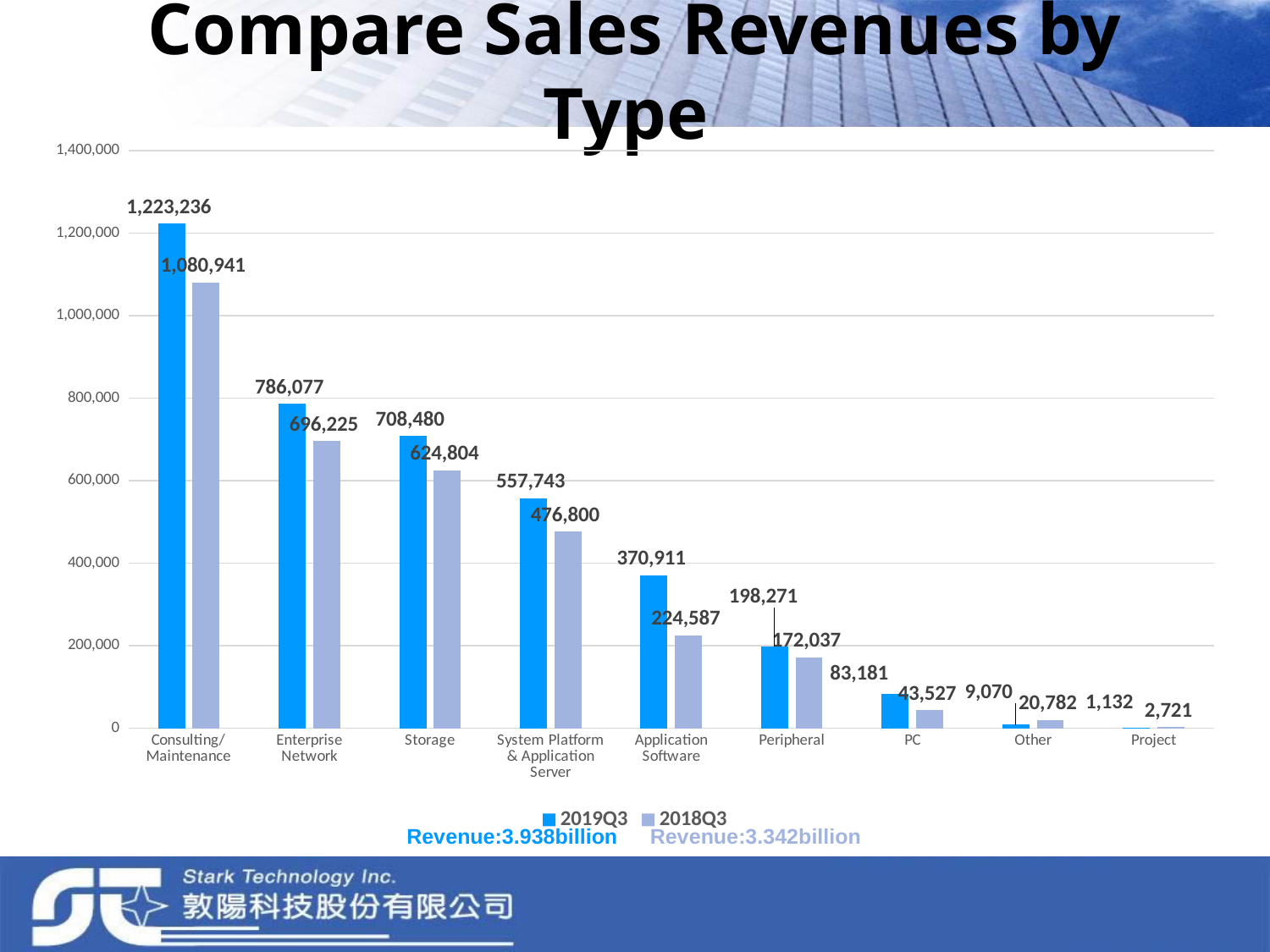
What is the difference between the 2019Q3 and 2018Q3 values for Consulting/Maintenance? 142,295 What is the 2018Q3 value for PC? 43,527 What is the 2019Q3 value for Application Software? 370,911 Which category has the highest 2019Q3 value? Consulting/Maintenance What kind of chart is shown on the slide? Bar chart How many series does the legend list? 2 Which category has the lowest 2019Q3 value? Project What is the 2018Q3 value for Storage? 624,804 What is the difference between the 2018Q3 and 2019Q3 values for Other? 11,712 What is the 2019Q3 value for Consulting/Maintenance? 1,223,236 How many categories are shown on the x axis? 9 Which is larger for Other: the 2019Q3 value or the 2018Q3 value? 2018Q3